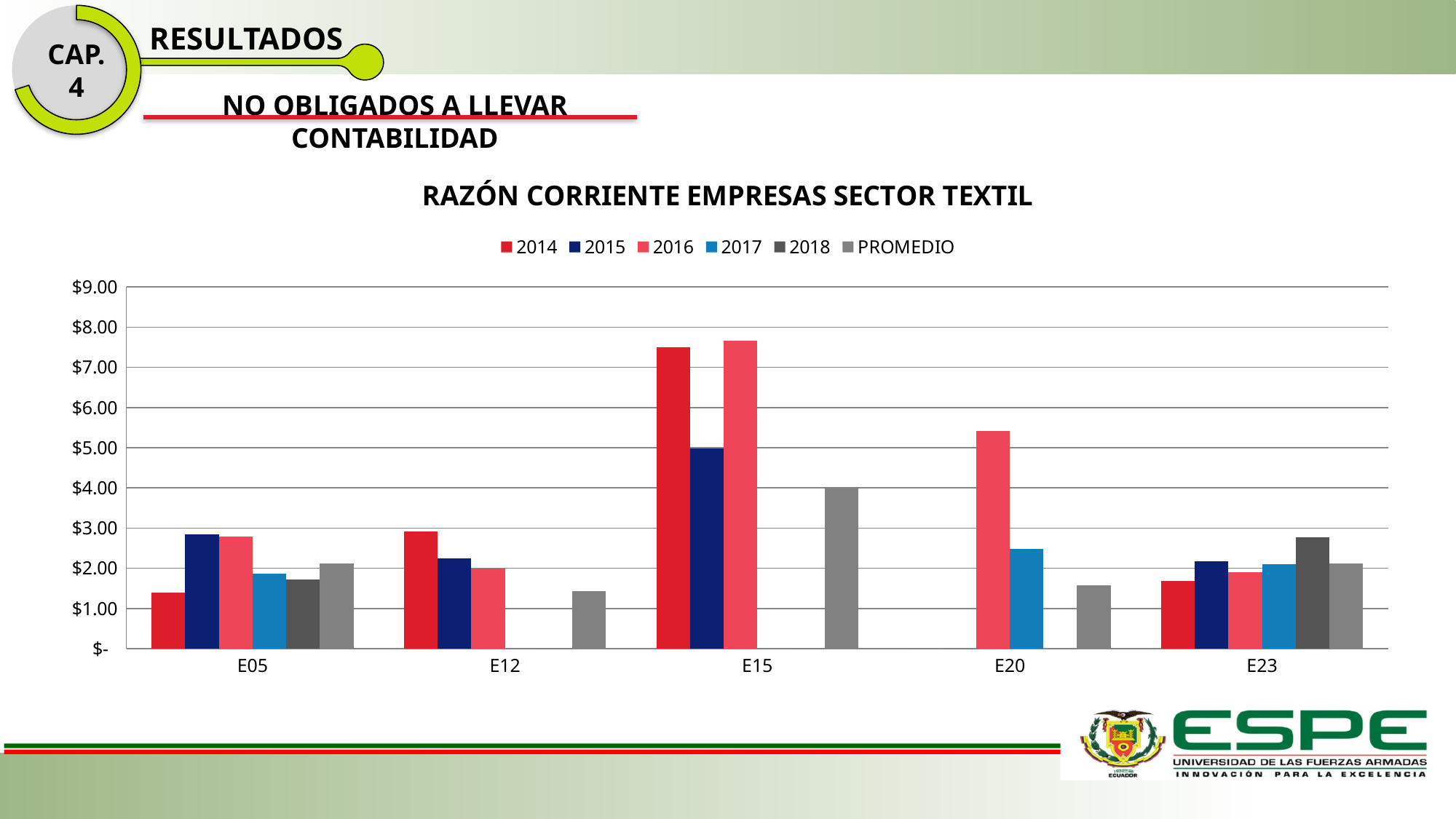
Is the 2014 value for E15 greater or less than $7.00? greater What is the title of the chart? RAZÓN CORRIENTE EMPRESAS SECTOR TEXTIL Is the 2014 value for E05 greater or less than $2.00? less For E12, which year has the highest value? 2014 Which company has the highest PROMEDIO value? E15 Is the 2016 value for E20 greater or less than $5.00? greater For E05, which is larger, the 2014 value or the 2015 value? 2015 How many companies (categories) are shown on the x axis? 5 How many series does the legend list? 6 What kind of chart is shown on the slide? bar chart For E15, which is larger, the 2014 value or the 2015 value? 2014